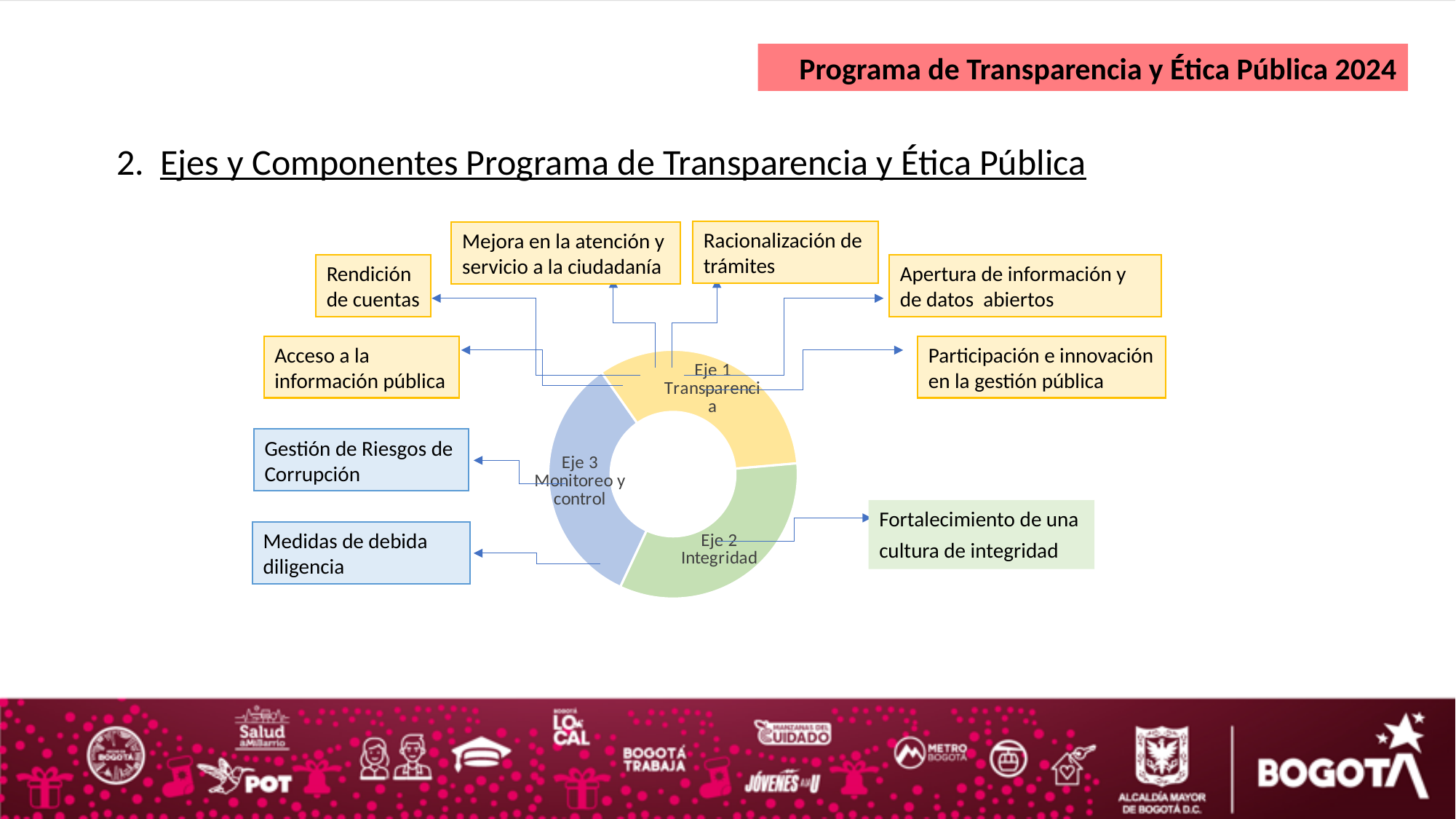
Which segment of the doughnut chart is coloured blue? Eje 3 Monitoreo y control Which eje in the doughnut chart is linked to the component 'Fortalecimiento de una cultura de integridad'? Eje 2 Integridad Which eje in the doughnut chart is linked to 'Gestión de Riesgos de Corrupción'? Eje 3 Monitoreo y control How many component boxes are connected to the Eje 1 Transparencia segment? 6 What kind of chart is shown in the centre of the slide? Doughnut chart How many component boxes are connected to the Eje 3 Monitoreo y control segment? 2 What is the label of the yellow segment of the doughnut chart? Eje 1 Transparencia What is the label of the green segment of the doughnut chart? Eje 2 Integridad How many segments (ejes) does the doughnut chart have? 3